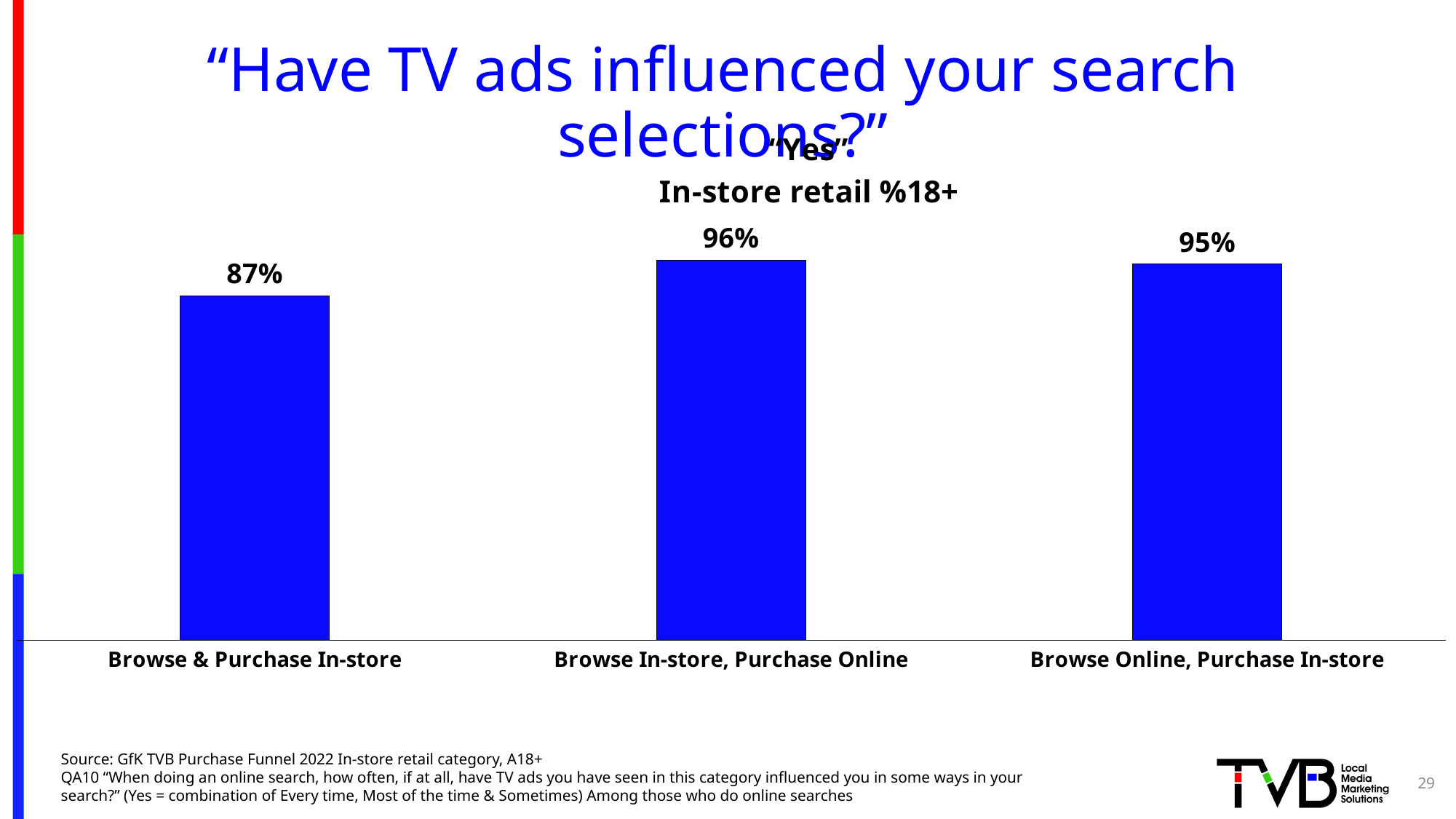
Which category has the lowest value? Browse & Purchase In-store What is the value for Browse In-store, Purchase Online? 96% What is the value for Browse & Purchase In-store? 87% What kind of chart is shown on the slide? Bar chart Which is larger: the value for Browse & Purchase In-store or the value for Browse Online, Purchase In-store? Browse Online, Purchase In-store What is the chart's subtitle below "Yes"? In-store retail %18+ What is the difference between the values for Browse In-store, Purchase Online and Browse & Purchase In-store? 9% What is the difference between the values for Browse Online, Purchase In-store and Browse & Purchase In-store? 8% Which category has the highest value? Browse In-store, Purchase Online What is the value for Browse Online, Purchase In-store? 95% What colour are the bars in the chart? Blue How many categories are shown in the chart? 3